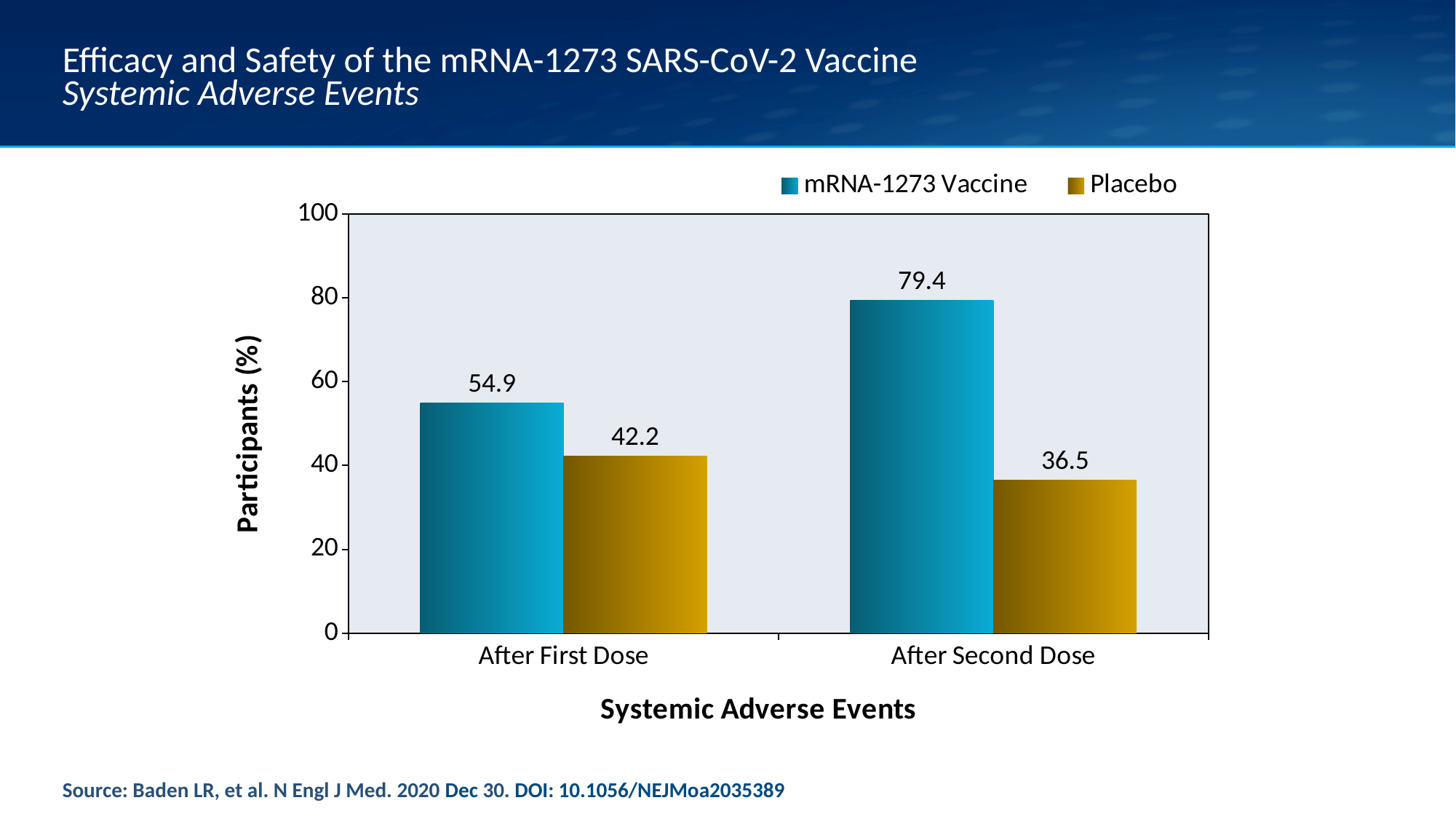
What kind of chart is shown on the slide? Bar chart What is the difference between the mRNA-1273 Vaccine and Placebo values after the second dose? 42.9 Is the value for the mRNA-1273 Vaccine group after the second dose greater or less than 60? greater How many series does the legend list? 2 What is the value for the Placebo group after the first dose? 42.2 Which bar shows the highest percentage of participants with systemic adverse events? mRNA-1273 Vaccine, After Second Dose What is the label of the y axis? Participants (%) After the first dose, which group had a higher percentage of participants with systemic adverse events, mRNA-1273 Vaccine or Placebo? mRNA-1273 Vaccine What is the difference between the mRNA-1273 Vaccine values after the second dose and after the first dose? 24.5 Which bar shows the lowest percentage of participants with systemic adverse events? Placebo, After Second Dose What percentage of participants in the mRNA-1273 Vaccine group had systemic adverse events after the first dose? 54.9 What percentage of participants in the Placebo group had systemic adverse events after the second dose? 36.5